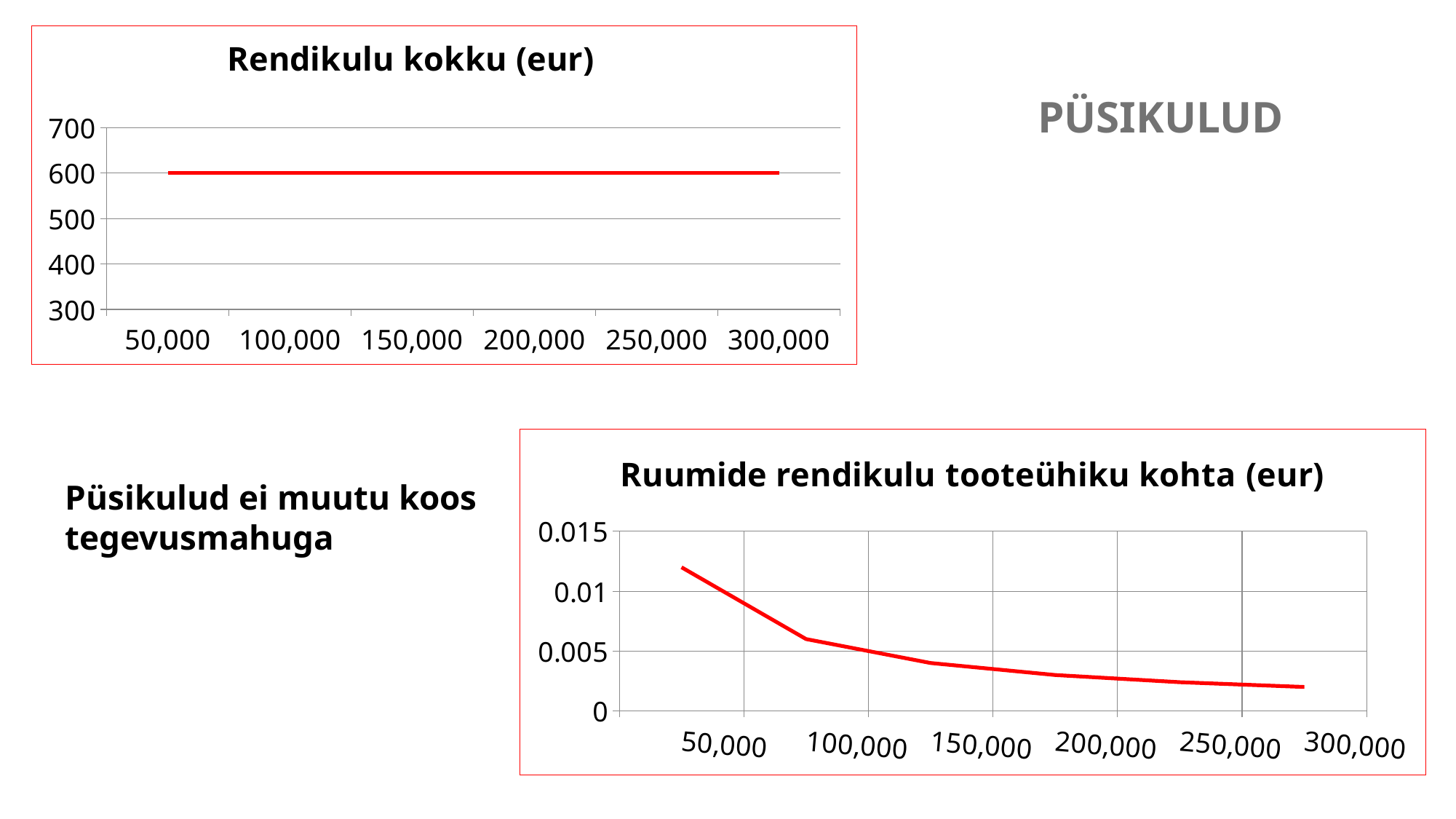
In the chart "Ruumide rendikulu tooteühiku kohta (eur)", is the value at 300,000 greater or less than 0.005? less In the chart "Rendikulu kokku (eur)", what is the value at 50,000? 600 In the chart "Rendikulu kokku (eur)", do the values rise, fall or stay flat as the x axis increases? stay flat In the chart "Ruumide rendikulu tooteühiku kohta (eur)", do the values rise or fall as the x axis increases? fall What type of chart is "Rendikulu kokku (eur)"? line chart In the chart "Rendikulu kokku (eur)", is the value at 150,000 greater or less than 500? greater In the chart "Ruumide rendikulu tooteühiku kohta (eur)", is the value at 50,000 greater or less than 0.01? greater In the chart "Rendikulu kokku (eur)", how many x-axis categories are shown? 6 In the chart "Rendikulu kokku (eur)", what is the value at 300,000? 600 What type of chart is "Ruumide rendikulu tooteühiku kohta (eur)"? line chart What colour is the line in the chart "Ruumide rendikulu tooteühiku kohta (eur)"? red In the chart "Ruumide rendikulu tooteühiku kohta (eur)", which is larger, the value at 50,000 or the value at 250,000? 50,000